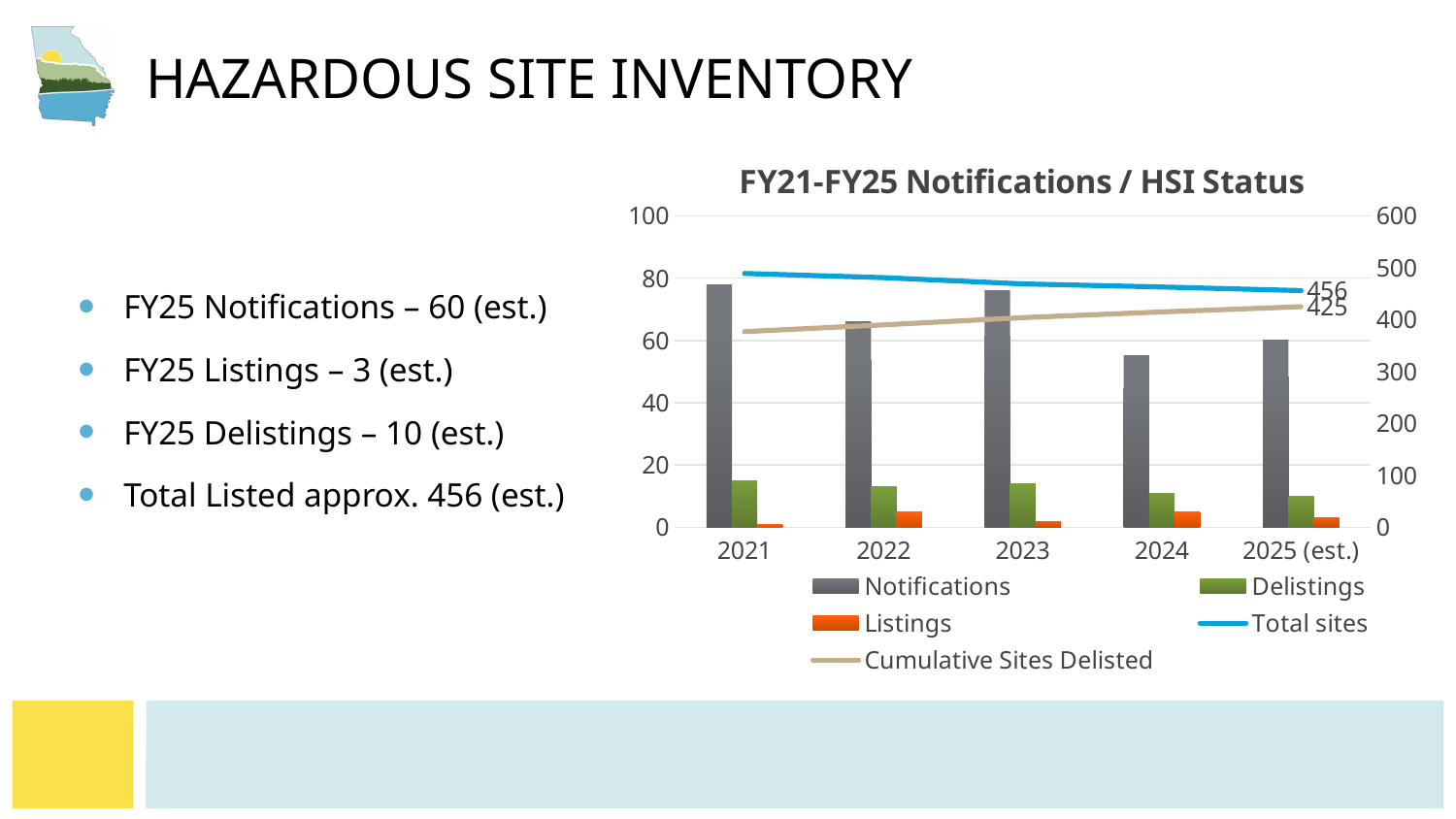
Is the Notifications value for 2021 greater or less than 60? greater In which year are Notifications lowest? 2024 Does the Total sites line rise or fall from 2021 to 2025 (est.)? Fall What is the value of the Total sites series for 2025 (est.)? 456 How many series does the chart's legend list? 5 Is the Notifications value for 2024 greater or less than 60? less What is the value of the Cumulative Sites Delisted series for 2025 (est.)? 425 How many years are shown on the x axis of the chart? 5 What kind of chart is shown on the slide? Combined bar and line chart Which year has more Notifications, 2021 or 2024? 2021 What is the title of the chart? FY21-FY25 Notifications / HSI Status Is the Delistings value for 2021 greater or less than 20? less